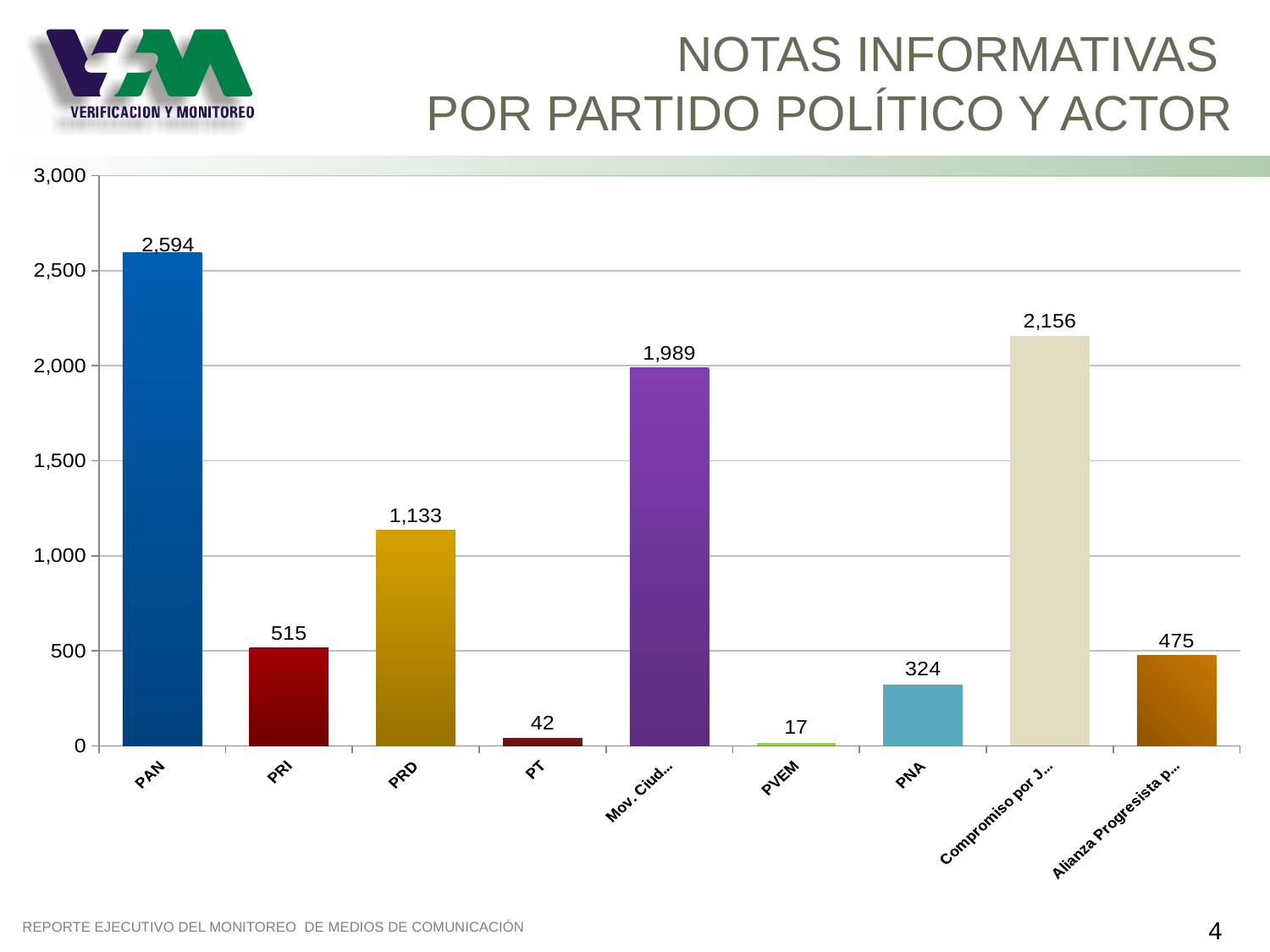
How many categories are shown on the x axis? 9 What is the value for PNA? 324 Which category has the highest value? PAN What is the difference between the values for PAN and PRI? 2,079 What is the value for PVEM? 17 What is the value for PAN? 2,594 What kind of chart is shown on the slide? Bar chart What is the difference between the values for PRI and PT? 473 Which category has the lowest value? PVEM What is the title of the slide? NOTAS INFORMATIVAS POR PARTIDO POLÍTICO Y ACTOR What is the value for PRD? 1,133 Which is larger, the value for PRD or the value for PNA? PRD